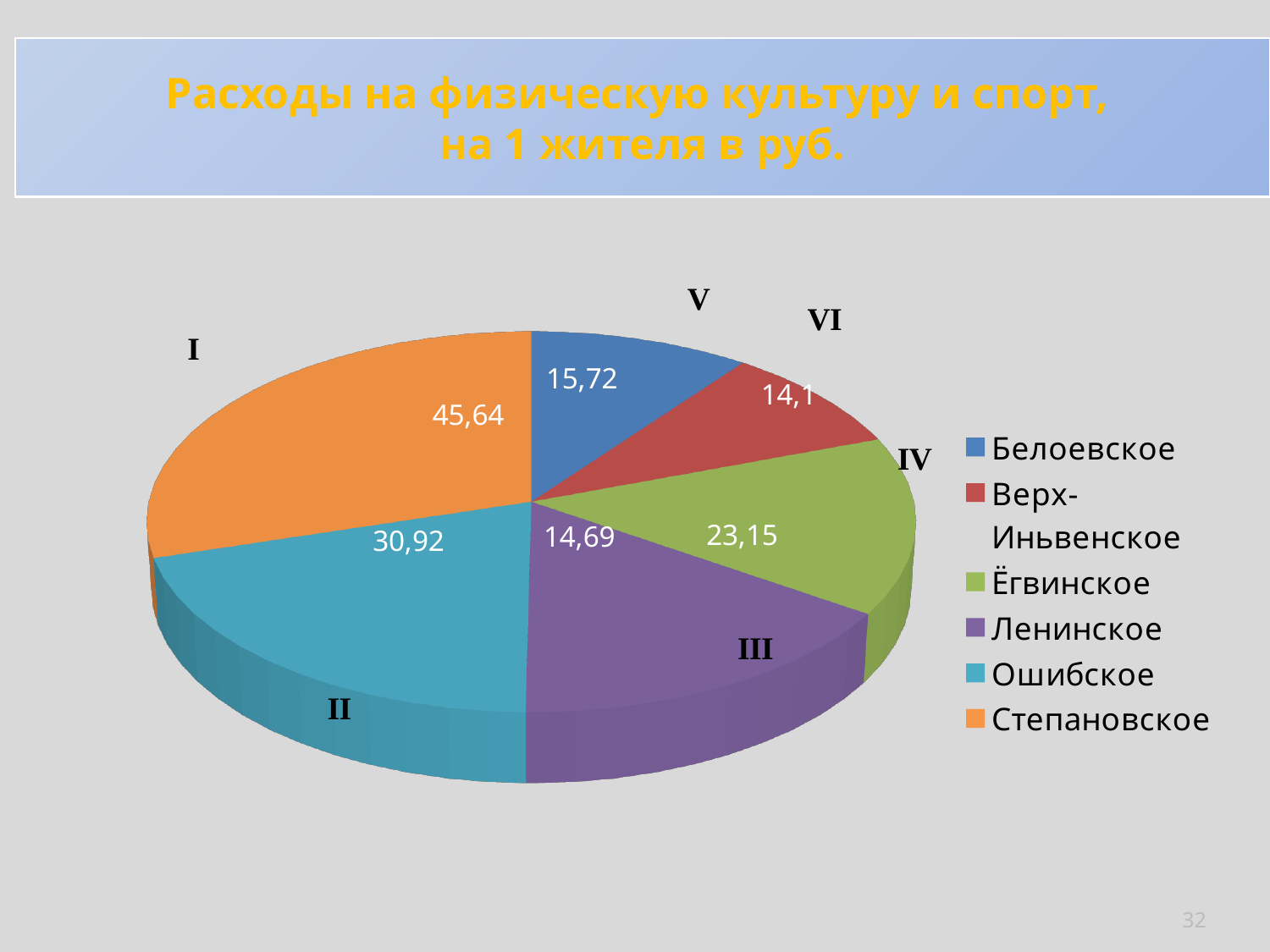
What is the value for Ошибское? 30,92 What is the value for Ёгвинское? 23,15 What is the value for Верх-Иньвенское? 14,1 Which category has the smallest value? Верх-Иньвенское What is the title of the chart on the slide? Расходы на физическую культуру и спорт, на 1 жителя в руб. Which category has the largest slice of the pie? Степановское How many slices does the pie chart have? 6 What is the value for Степановское? 45,64 What is the difference between the values for Степановское and Ошибское? 14,72 What type of chart is shown on the slide? pie chart What is the value for Белоевское? 15,72